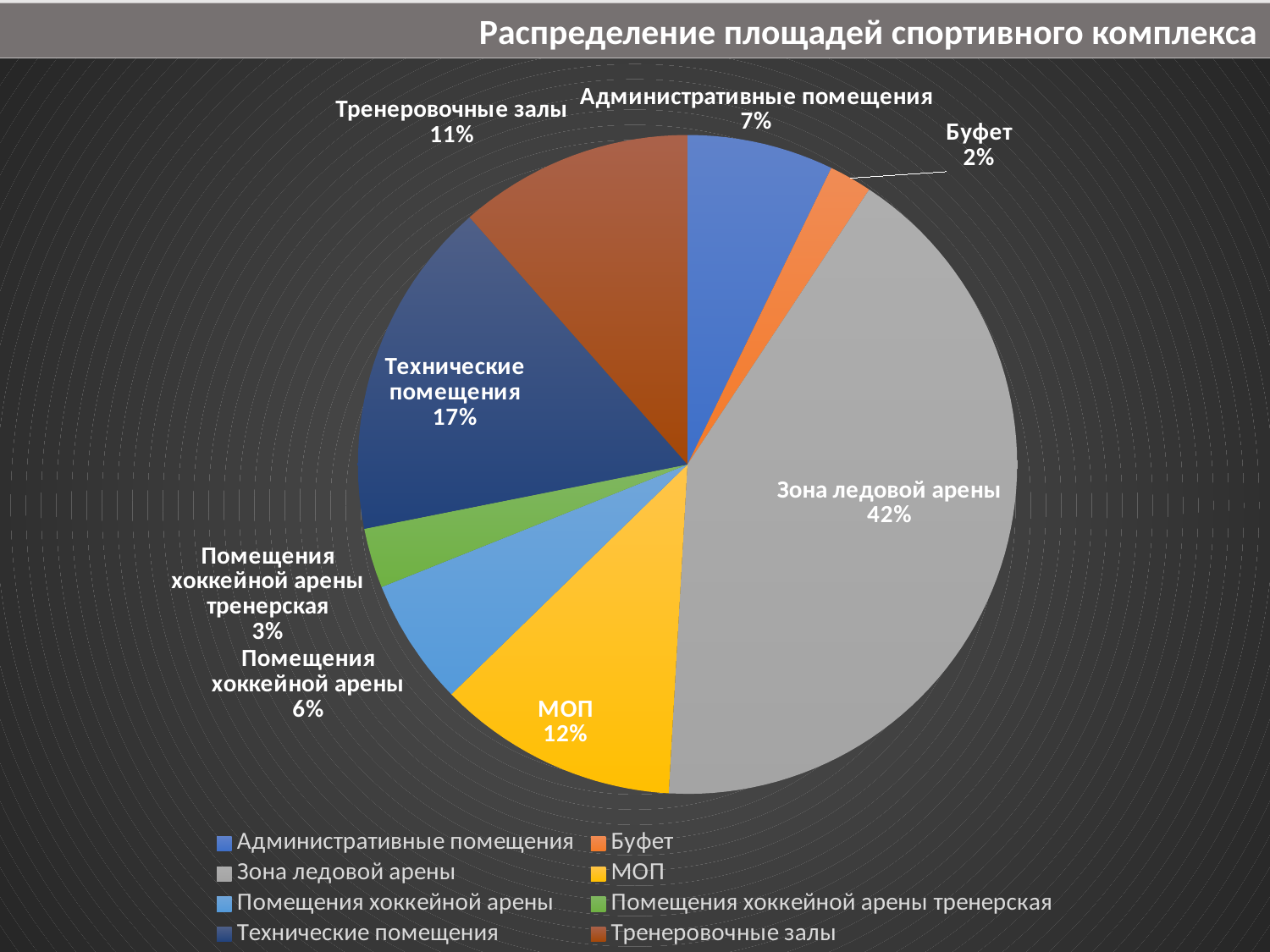
What is the value for Буфет? 2% Which category has the smallest slice? Буфет What is the difference between Технические помещения and Тренеровочные залы? 6% What is the value for МОП? 12% How many categories are shown in the pie chart? 8 What type of chart is shown on the slide? pie chart Which is larger, Помещения хоккейной арены or Административные помещения? Административные помещения What is the title of the chart? Распределение площадей спортивного комплекса What is the value for Технические помещения? 17% What is the value for Помещения хоккейной арены тренерская? 3% What share of the pie does Зона ледовой арены take? 42% Which category has the largest slice? Зона ледовой арены